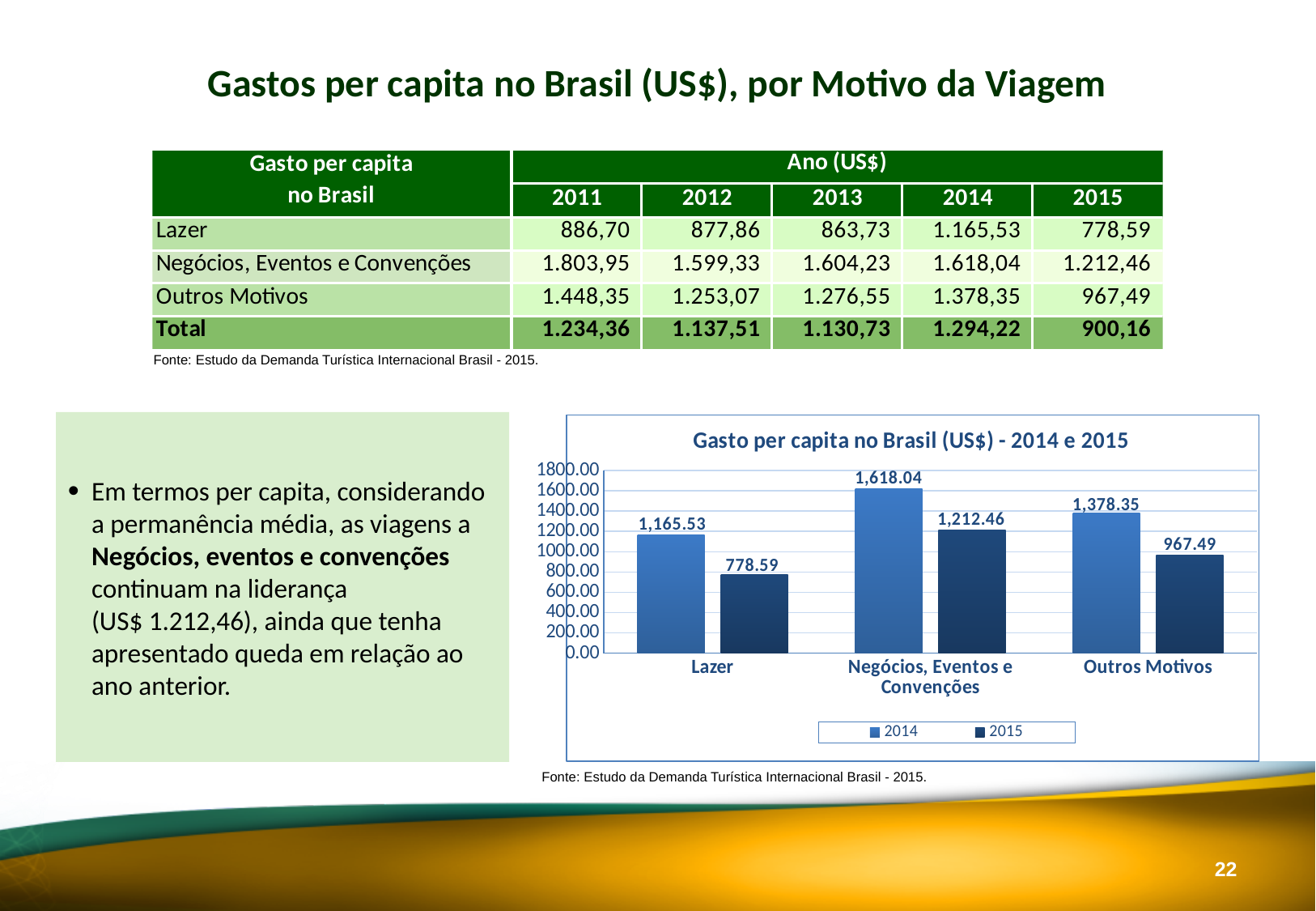
What is the difference between the 2014 and 2015 values for Lazer in the chart? 386.94 Is the 2014 value for Outros Motivos in the chart greater or less than 1200.00? greater How many series does the chart legend list? 2 What is the title of the chart on the slide? Gasto per capita no Brasil (US$) - 2014 e 2015 Which is larger in the chart: the 2015 value for Outros Motivos or the 2015 value for Lazer? Outros Motivos Which category has the highest 2014 value in the chart? Negócios, Eventos e Convenções What is the 2015 value for Negócios, Eventos e Convenções in the chart? 1,212.46 What type of chart is shown on the slide? bar chart What is the 2014 value for Lazer in the chart? 1,165.53 Which category has the lowest 2015 value in the chart? Lazer How many categories are shown on the x axis of the chart? 3 What is the 2015 value for Outros Motivos in the chart? 967.49